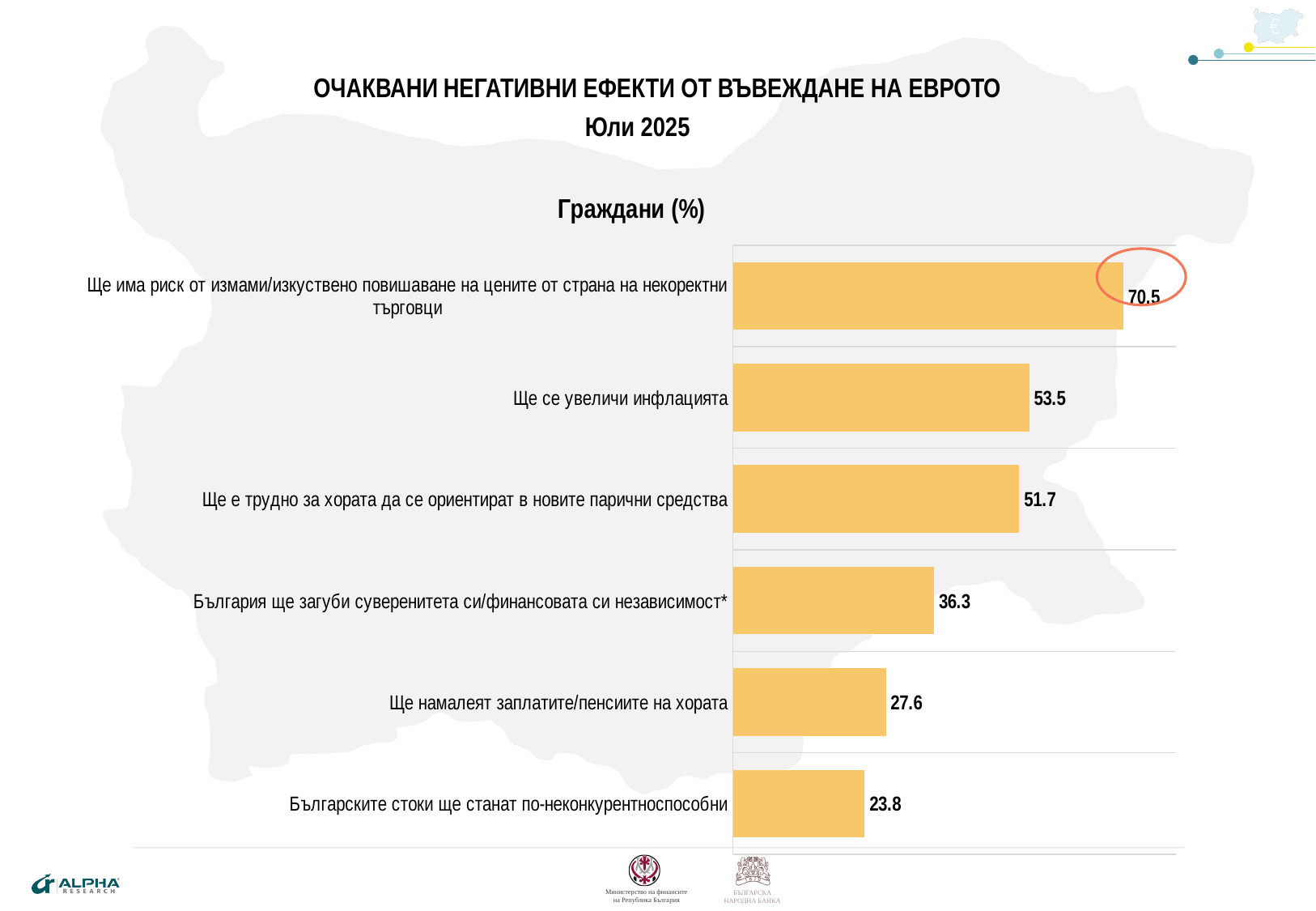
What is the difference between the highest and lowest values on the chart? 46.7 What is the difference between the values for "Ще се увеличи инфлацията" and "Ще е трудно за хората да се ориентират в новите парични средства"? 1.8 How many categories are shown on the chart? 6 Which category has the lowest value? Българските стоки ще станат по-неконкурентноспособни What is the value for "Българските стоки ще станат по-неконкурентноспособни"? 23.8 Which is larger: the value for "България ще загуби суверенитета си/финансовата си независимост*" or the value for "Ще намалеят заплатите/пенсиите на хората"? България ще загуби суверенитета си/финансовата си независимост* What is the value for "Ще намалеят заплатите/пенсиите на хората"? 27.6 Which category has the highest value? Ще има риск от измами/изкуствено повишаване на цените от страна на некоректни търговци What is the title of the chart? Граждани (%) What is the value for "България ще загуби суверенитета си/финансовата си независимост*"? 36.3 What kind of chart is shown on the slide? Bar chart What is the value for "Ще се увеличи инфлацията"? 53.5